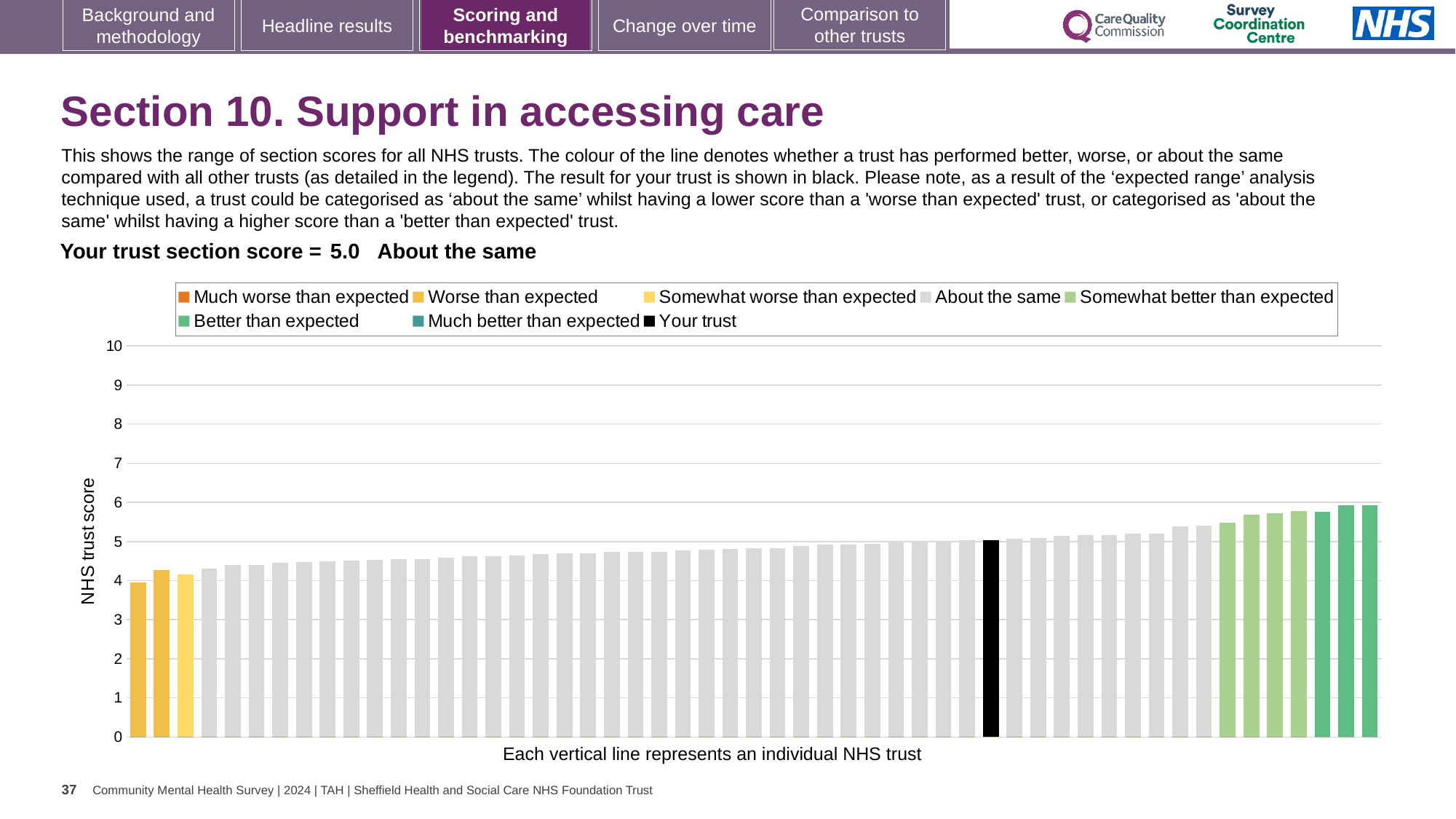
Do the bar values rise or fall from left to right along the x axis? rise What is the highest value shown on the y axis of the chart? 10 How many entries does the chart legend list? 8 Is the value of the shortest bar greater or less than 5? less What kind of chart is shown on the slide? bar chart Which performance category is your trust placed in for this section? About the same What does the caption below the x axis say each vertical line represents? an individual NHS trust What is the label of the y axis? NHS trust score What is the section score for your trust shown on the slide? 5.0 Is the value of the black 'Your trust' bar greater or less than 4? greater